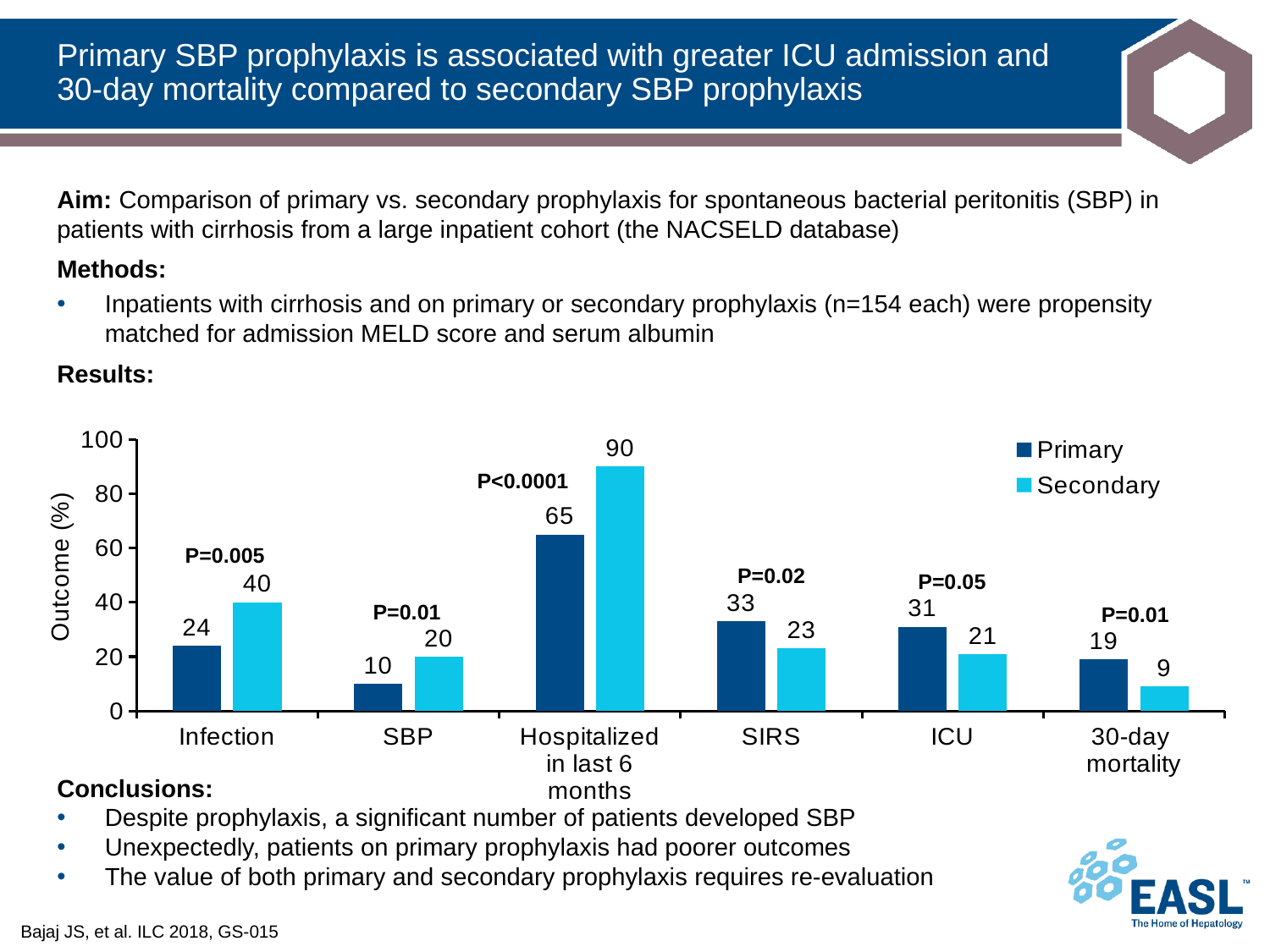
What is the y-axis label of the chart? Outcome (%) Which category has the highest Primary value? Hospitalized in last 6 months What kind of chart is shown? Bar chart What is the difference between the Secondary and Primary values for Infection? 16 What is the Primary value for Infection? 24 What is the Secondary value for Hospitalized in last 6 months? 90 Which category has the lowest Secondary value? 30-day mortality Which is larger for ICU, the Primary or Secondary value? Primary What P value is shown above the SIRS bars? P=0.02 How many categories are shown on the x axis? 6 How many series does the legend list? 2 What is the Secondary value for 30-day mortality? 9